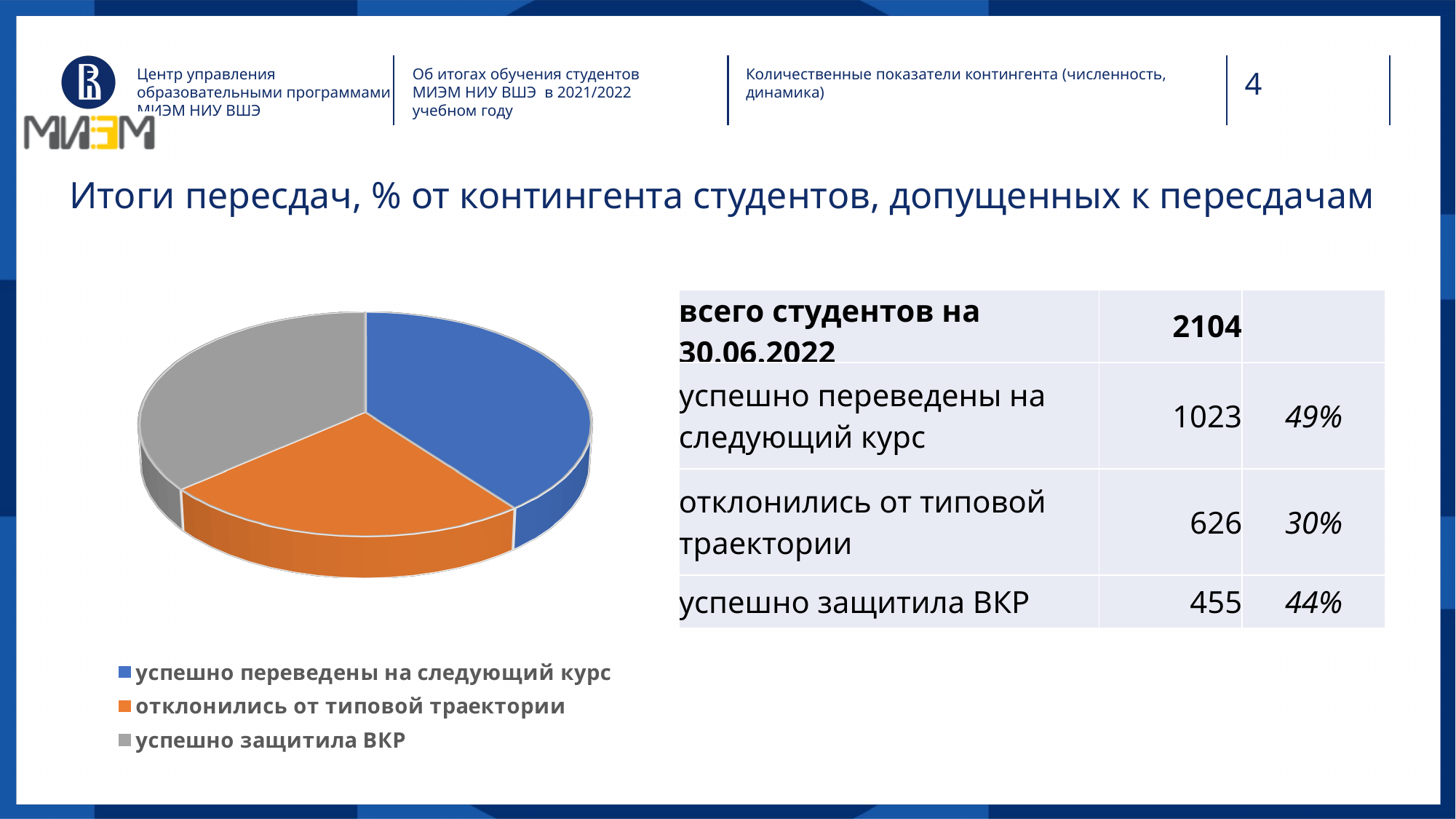
Which category does the blue slice of the pie chart represent? успешно переведены на следующий курс In the pie chart, which slice is larger: "успешно переведены на следующий курс" or "отклонились от типовой траектории"? успешно переведены на следующий курс Which category has the smallest slice in the pie chart? отклонились от типовой траектории Which category has the largest slice in the pie chart? успешно переведены на следующий курс According to the table next to the chart, how many students were successfully transferred to the next year (успешно переведены на следующий курс)? 1023 How many entries does the legend of the pie chart list? 3 According to the table next to the chart, what is the total number of students as of 30.06.2022? 2104 According to the table next to the chart, what percentage is shown for "отклонились от типовой траектории"? 30% What kind of chart is shown on the slide? pie chart How many slices does the pie chart have? 3 According to the table next to the chart, what is the difference between the number of students who were transferred to the next year (1023) and those who deviated from the standard trajectory (626)? 397 What colour is the slice for "успешно защитила ВКР" in the pie chart? grey